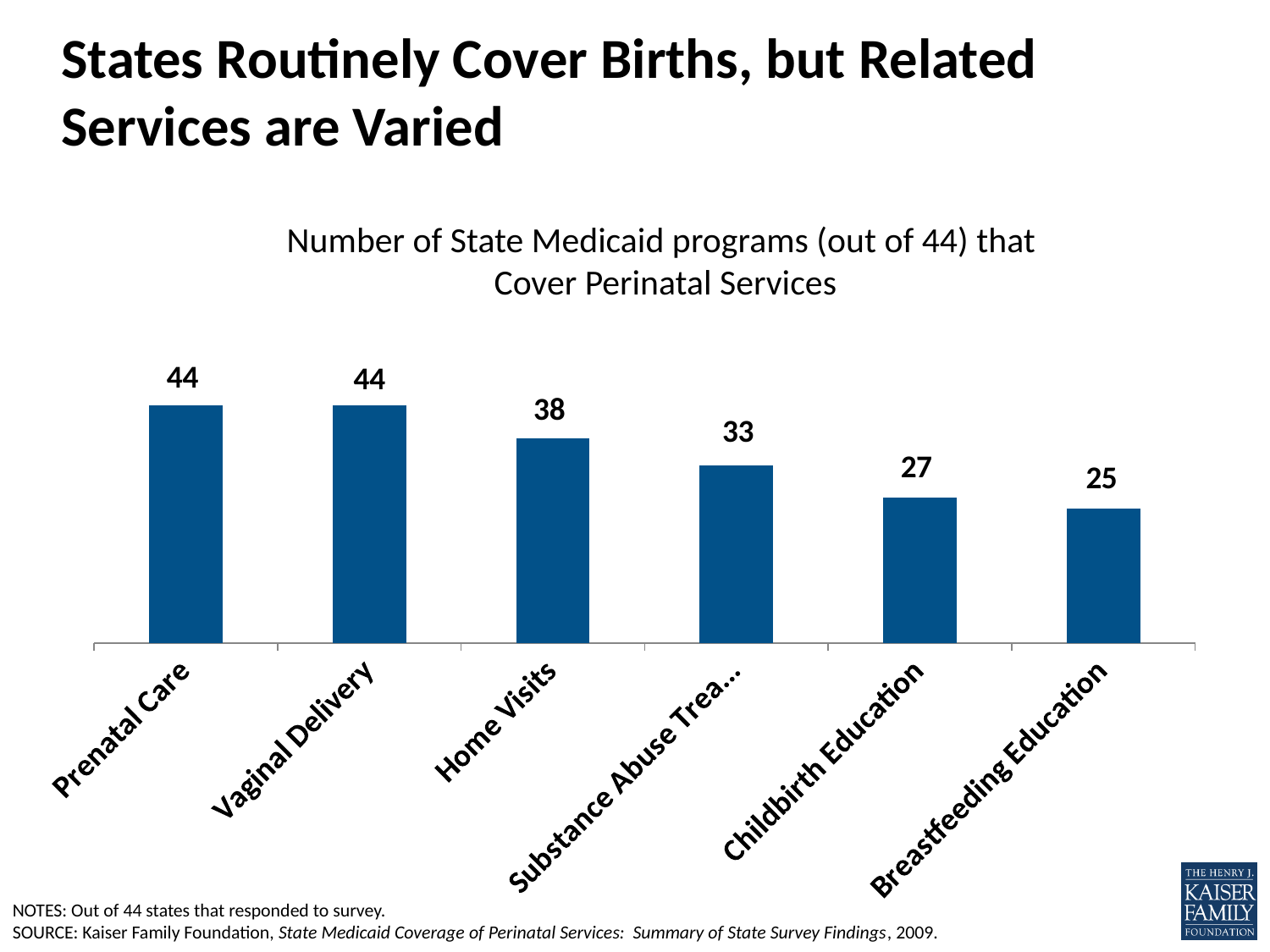
What is the difference between the values for Vaginal Delivery and Childbirth Education? 17 What is the value shown for Childbirth Education? 27 How many state Medicaid programs cover Breastfeeding Education? 25 Which has a higher value, Home Visits or Childbirth Education? Home Visits How many state Medicaid programs cover Prenatal Care? 44 What kind of chart is shown on the slide? Bar chart Which service is covered by the fewest state Medicaid programs? Breastfeeding Education Do the values rise or fall moving from left to right across the chart? Fall How many categories are shown in the chart? 6 What is the value shown for Vaginal Delivery? 44 How many state Medicaid programs cover Home Visits? 38 What is the difference between the values for Home Visits and Breastfeeding Education? 13